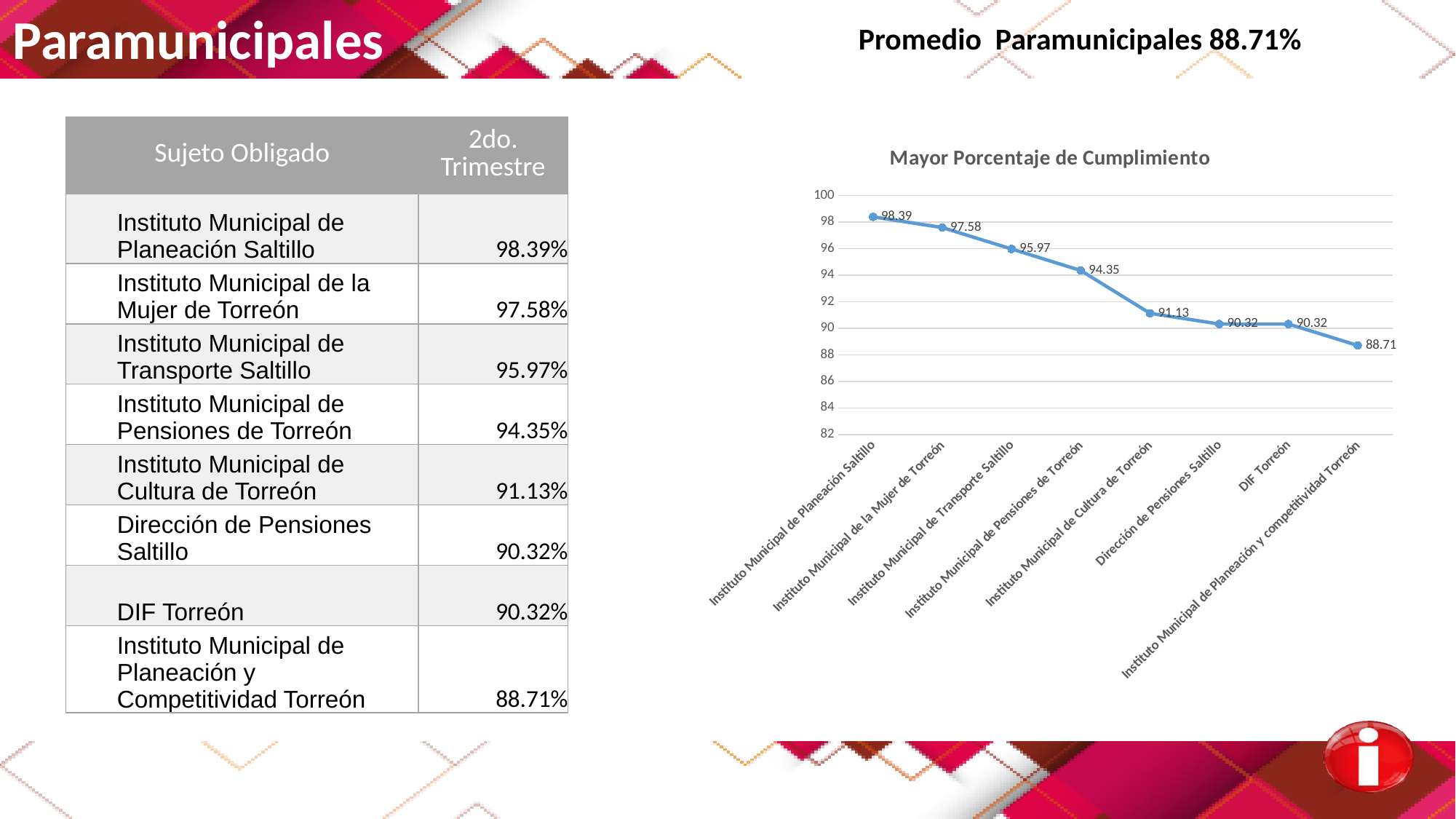
Which category has the highest value on the chart? Instituto Municipal de Planeación Saltillo What is the title of the chart? Mayor Porcentaje de Cumplimiento What is the value for DIF Torreón on the chart? 90.32 Is the value for Instituto Municipal de la Mujer de Torreón greater or less than 96? greater What is the value for Instituto Municipal de Planeación Saltillo on the chart? 98.39 What is the value for Instituto Municipal de Transporte Saltillo on the chart? 95.97 What is the difference between the values for Instituto Municipal de Planeación Saltillo and Instituto Municipal de Planeación y competitividad Torreón? 9.68 Which is larger, the value for Instituto Municipal de Pensiones de Torreón or the value for Instituto Municipal de Cultura de Torreón? Instituto Municipal de Pensiones de Torreón How many data points are plotted on the chart? 8 Which category has the lowest value on the chart? Instituto Municipal de Planeación y competitividad Torreón What type of chart is shown on the slide? line chart Do the values rise or fall from left to right along the x axis? fall